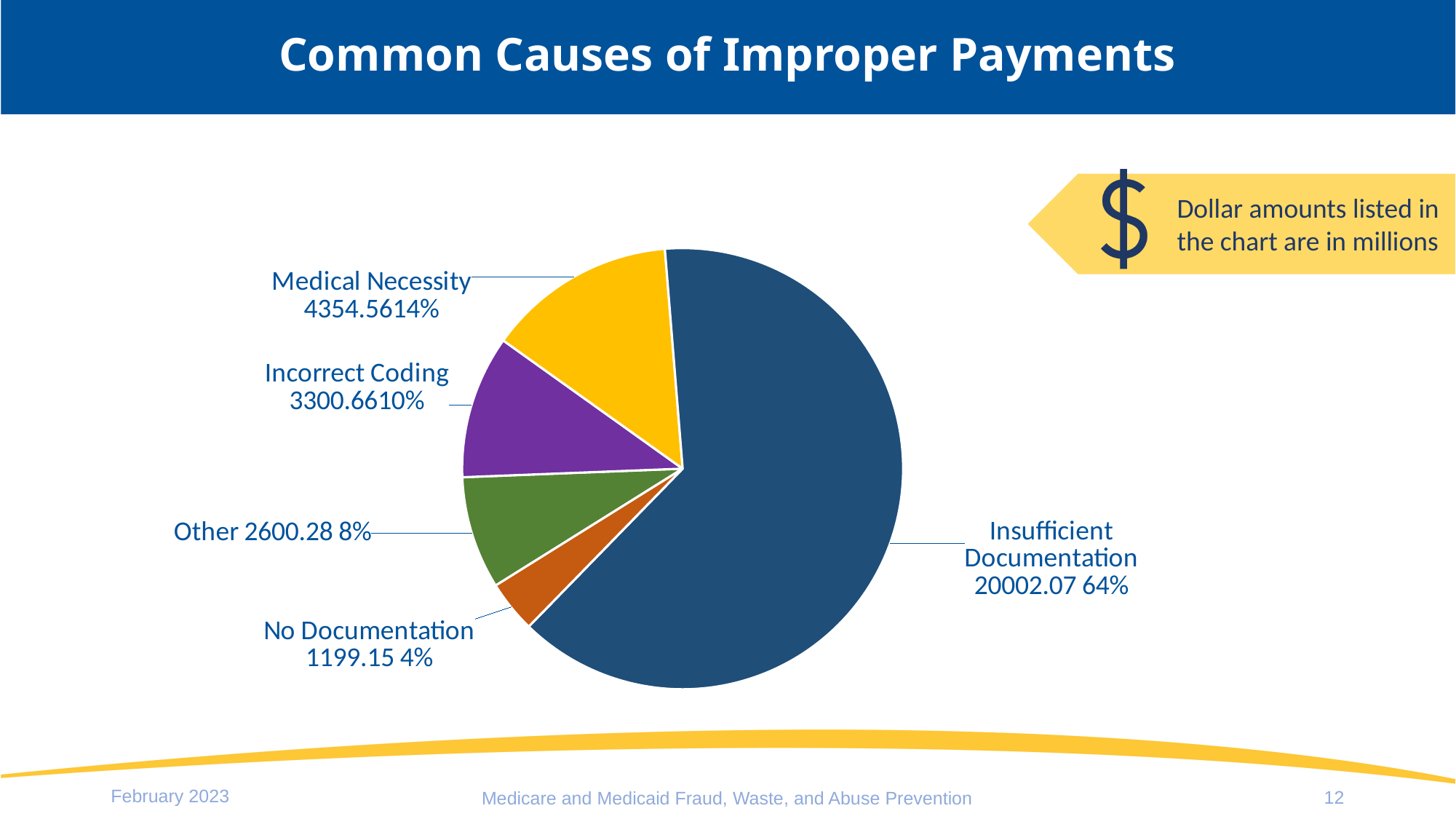
What percentage share of the pie does Other represent? 8% What percentage share of the pie does No Documentation represent? 4% Which cause accounts for the smallest share of improper payments? No Documentation Which cause accounts for the largest share of improper payments? Insufficient Documentation What dollar amount (in millions) is shown for Insufficient Documentation? 20002.07 According to the callout on the slide, in what units are the dollar amounts in the chart? millions How many slices does the pie chart have? 5 Which is larger, the amount for Other or the amount for No Documentation? Other What dollar amount (in millions) is shown for No Documentation? 1199.15 What percentage share of the pie does Insufficient Documentation represent? 64% What dollar amount (in millions) is shown for Other? 2600.28 What kind of chart is shown on the slide? pie chart